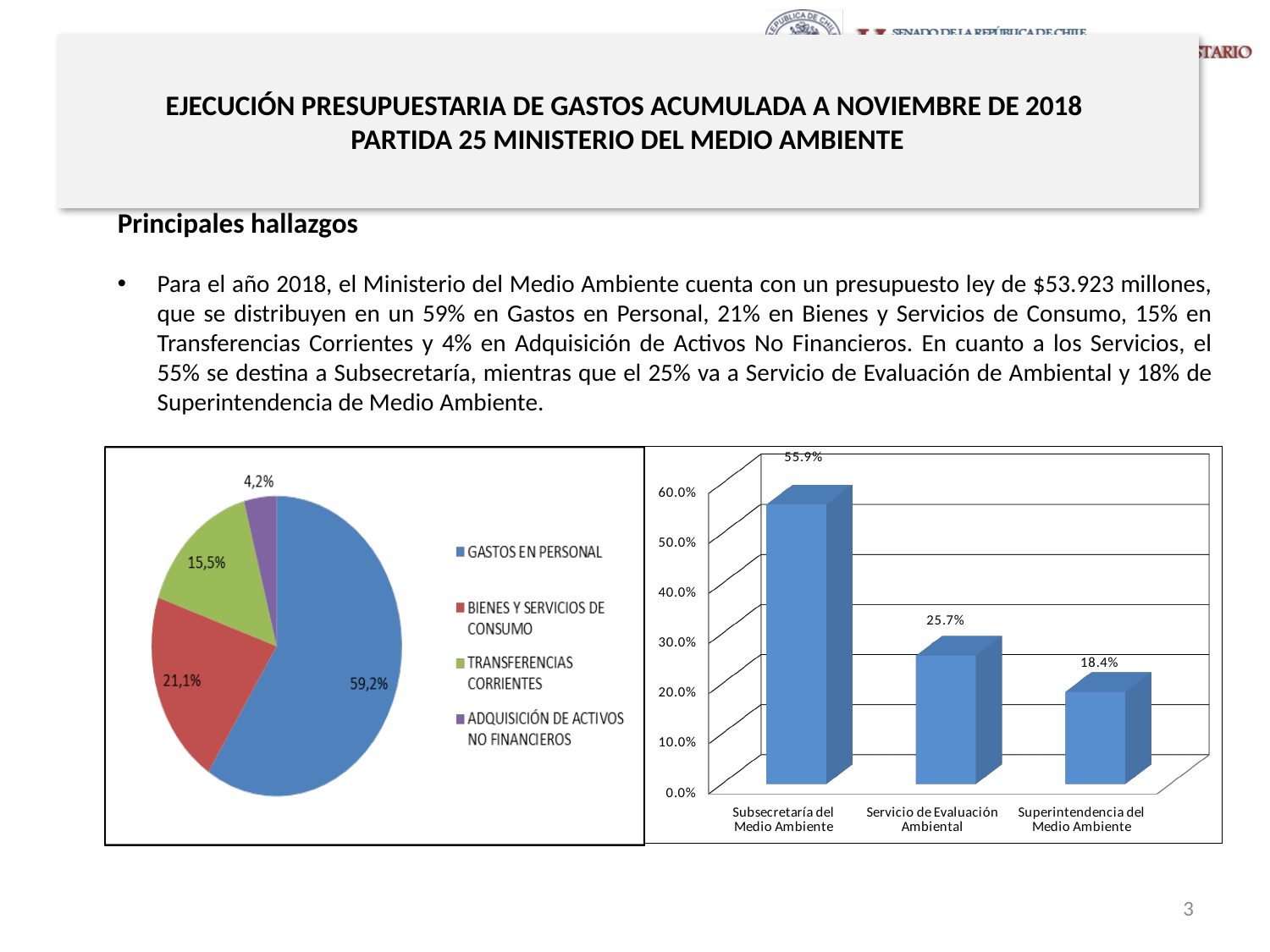
In the bar chart on the right, which category has the highest value? Subsecretaría del Medio Ambiente In the bar chart on the right, do the values rise or fall from left to right across the categories? Fall In the bar chart on the right, what is the value for Superintendencia del Medio Ambiente? 18.4% In the pie chart on the left, what share does TRANSFERENCIAS CORRIENTES have? 15,5% What kind of chart is the chart on the left of the slide? Pie chart In the pie chart on the left, how many categories does the legend list? 4 In the pie chart on the left, which category has the smallest slice? ADQUISICIÓN DE ACTIVOS NO FINANCIEROS In the bar chart on the right, what is the difference between Subsecretaría del Medio Ambiente and Superintendencia del Medio Ambiente? 37.5% In the pie chart on the left, what share does GASTOS EN PERSONAL have? 59,2% In the pie chart on the left, what share does BIENES Y SERVICIOS DE CONSUMO have? 21,1% In the pie chart on the left, what is the difference between the shares of GASTOS EN PERSONAL and BIENES Y SERVICIOS DE CONSUMO? 38,1% In the bar chart on the right, what is the value for Servicio de Evaluación Ambiental? 25.7%